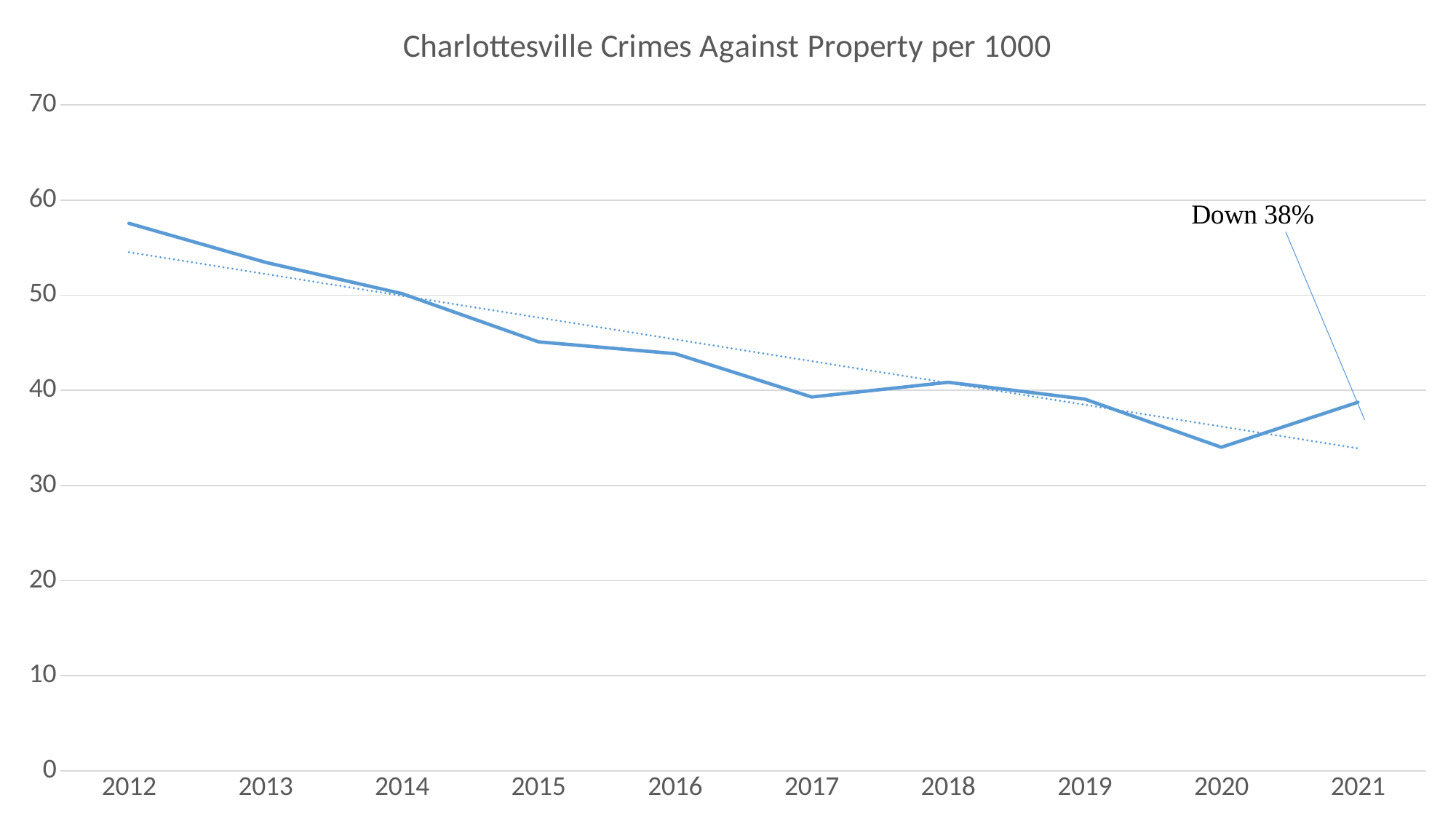
Overall, do the values rise or fall from 2012 to 2021? fall Which year has the lowest value? 2020 How many years are plotted along the x axis? 10 Is the value for 2016 greater or less than 40? greater What does the annotation near the end of the line say? Down 38% What kind of chart is shown on the slide? line chart Which is larger, the value for 2016 or the value for 2017? 2016 Which is larger, the value for 2012 or the value for 2021? 2012 Which year has the highest value? 2012 Is the value for 2020 greater or less than 40? less What is the title of the chart? Charlottesville Crimes Against Property per 1000 Is the value for 2012 greater or less than 50? greater